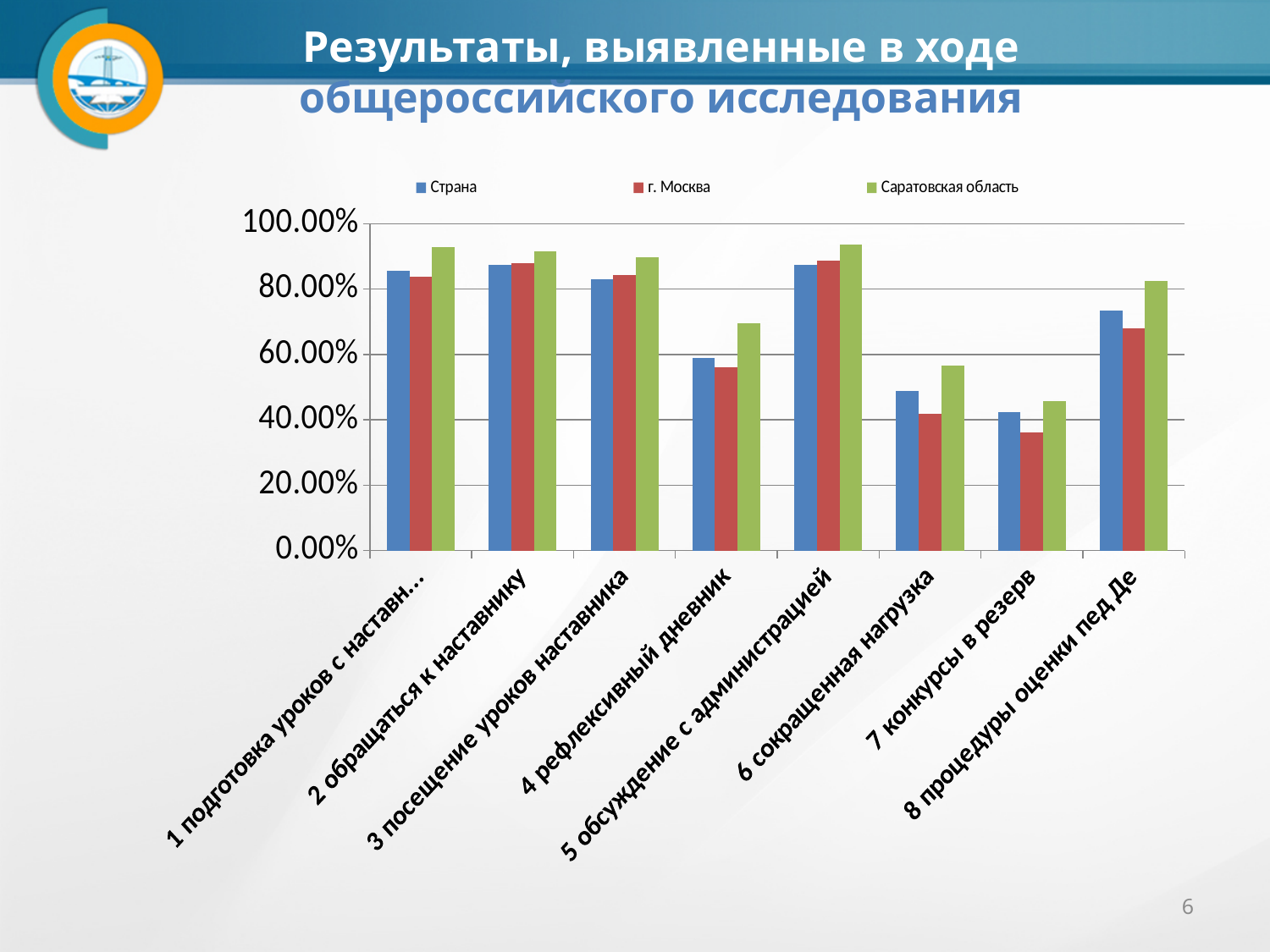
Is the value for г. Москва in the category '7 конкурсы в резерв' greater or less than 40.00%? less How many categories are shown on the x axis? 8 Is the value for Страна in the category '8 процедуры оценки пед Де' greater or less than 60.00%? greater Is the value for Саратовская область in the category '4 рефлексивный дневник' greater or less than 60.00%? greater How many series does the legend list? 3 Which series are listed in the legend? Страна, г. Москва, Саратовская область In the category '6 сокращенная нагрузка', which is larger: the value for Страна or for г. Москва? Страна For which category is the г. Москва value the lowest? 7 конкурсы в резерв What kind of chart is shown on the slide? bar chart In the category '4 рефлексивный дневник', which is larger: the value for Страна or for Саратовская область? Саратовская область For which category is the Саратовская область value the lowest? 7 конкурсы в резерв